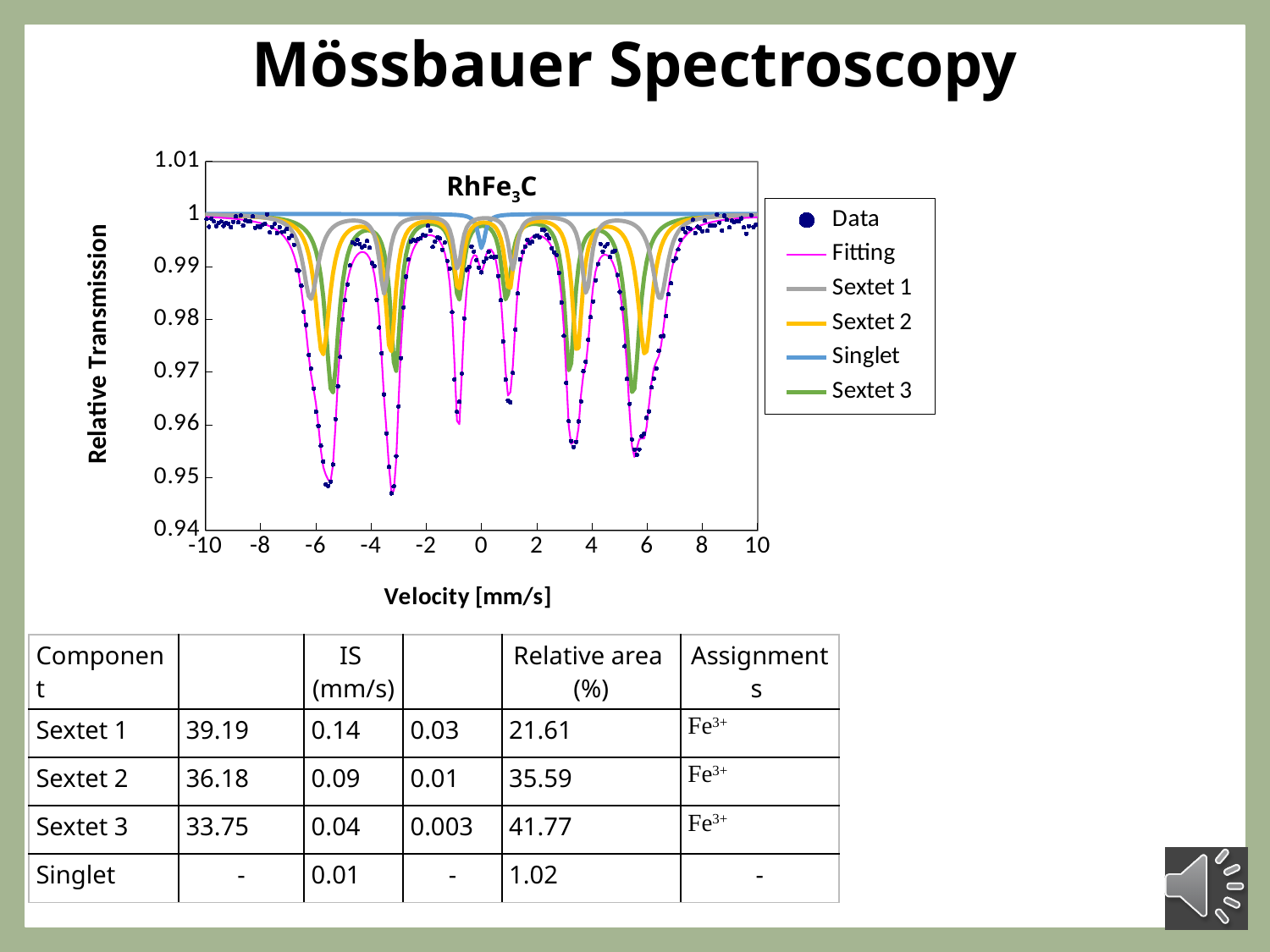
Which curve reaches a lower minimum near -5.5 mm/s, Sextet 1 or Sextet 3? Sextet 3 How many series does the chart legend list? 6 What kind of chart is shown on the slide? line chart Is the lowest value of the Sextet 1 curve near -6 mm/s greater or less than 0.98? greater Is the lowest value of the Fitting curve near -5.5 mm/s greater or less than 0.96? less Which of the fitted component curves (Sextet 1, Sextet 2, Sextet 3, Singlet) dips the least below 1? Singlet Is the lowest value of the Sextet 3 curve near -5.5 mm/s greater or less than 0.97? less Which series in the legend is shown as dots rather than a line? Data What is the title of the chart? RhFe3C